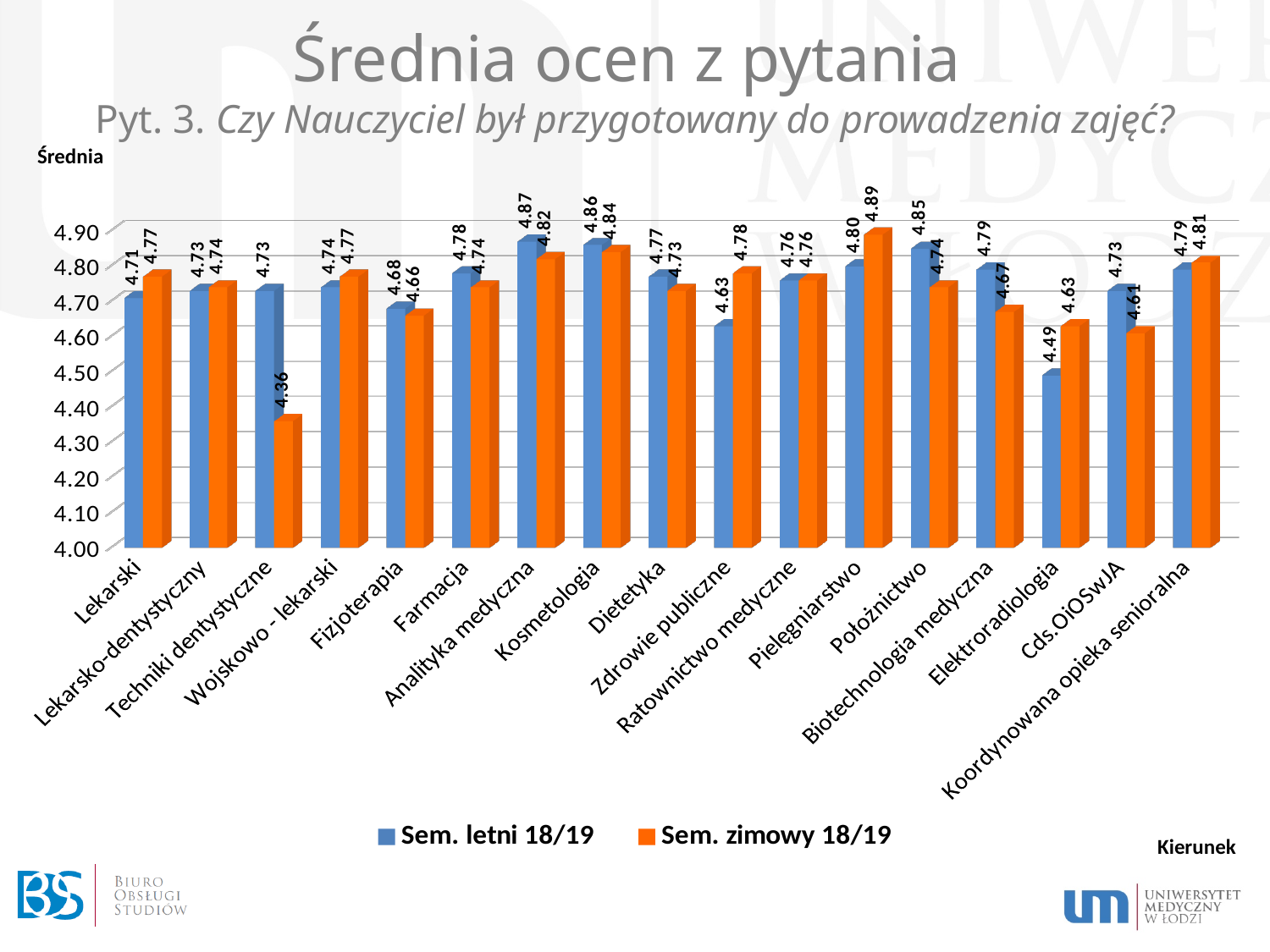
Which category has the lowest Sem. letni 18/19 value? Elektroradiologia Is the Sem. letni 18/19 value for Elektroradiologia greater or less than 4.50? less What is the Sem. zimowy 18/19 value for Techniki dentystyczne? 4.36 What is the Sem. zimowy 18/19 value for Pielęgniarstwo? 4.89 Which is larger for Położnictwo: the Sem. letni 18/19 value or the Sem. zimowy 18/19 value? Sem. letni 18/19 Which category has the lowest Sem. zimowy 18/19 value? Techniki dentystyczne How many series does the legend list? 2 What is the Sem. letni 18/19 value for Analityka medyczna? 4.87 Which category has the highest Sem. zimowy 18/19 value? Pielęgniarstwo How many categories (kierunki) are shown on the x axis? 17 What is the difference between the Sem. letni 18/19 and Sem. zimowy 18/19 values for Techniki dentystyczne? 0.37 What type of chart is shown on the slide? bar chart